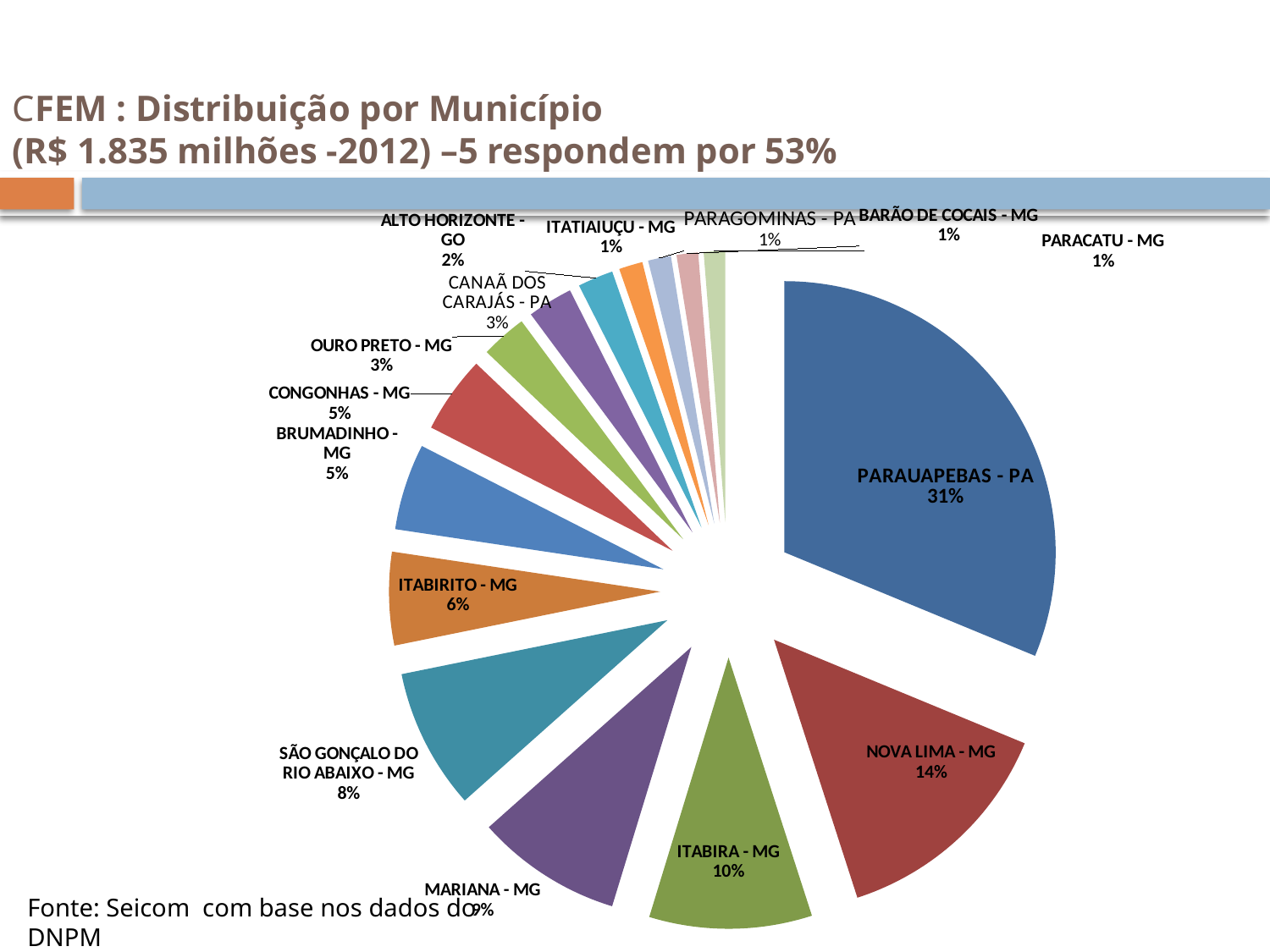
What percentage is shown for SÃO GONÇALO DO RIO ABAIXO - MG? 8% What kind of chart is shown on the slide? pie chart What percentage is shown for CANAÃ DOS CARAJÁS - PA? 3% What share of the CFEM distribution goes to PARAUAPEBAS - PA? 31% What percentage is shown for ITABIRITO - MG? 6% What percentage is shown for CONGONHAS - MG? 5% What percentage is shown for NOVA LIMA - MG? 14% What is the title of the chart on the slide? CFEM : Distribuição por Município (R$ 1.835 milhões -2012) –5 respondem por 53% What is the difference in percentage points between PARAUAPEBAS - PA and NOVA LIMA - MG? 17 percentage points Which municipality has the largest slice of the pie? PARAUAPEBAS - PA Which is larger, the share for ITABIRA - MG or the share for ITABIRITO - MG? ITABIRA - MG What percentage is shown for ITABIRA - MG? 10%